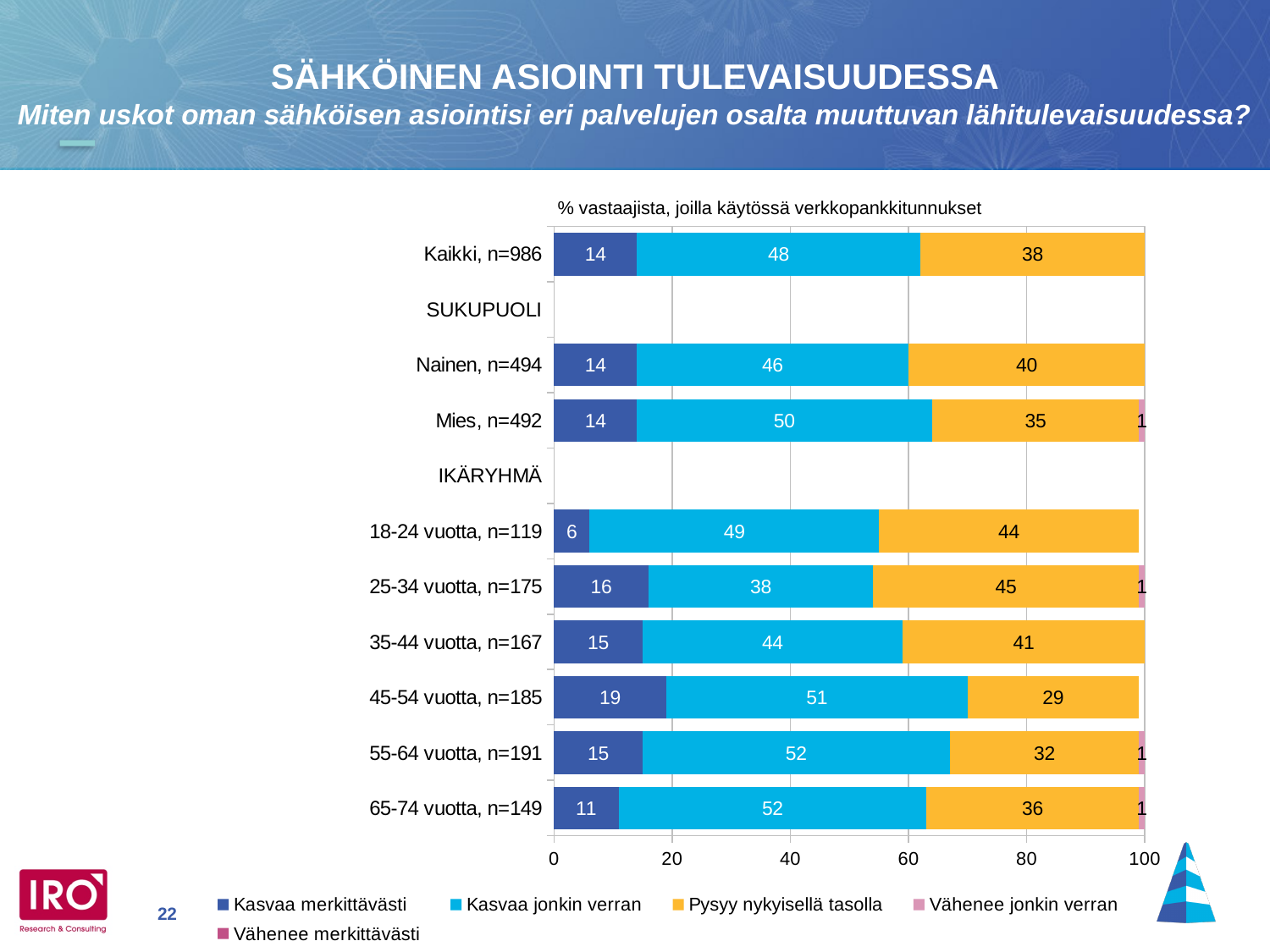
Which age group has the highest value for 'Kasvaa merkittävästi'? 45-54 vuotta, n=185 What percentage of all respondents (Kaikki, n=986) answered 'Kasvaa jonkin verran'? 48 What kind of chart is shown on the slide? Stacked bar chart What is the title shown above the chart? % vastaajista, joilla käytössä verkkopankkitunnukset What is the value of 'Kasvaa merkittävästi' for the 65-74 vuotta, n=149 group? 11 Which has a larger 'Kasvaa jonkin verran' value, Nainen, n=494 or Mies, n=492? Mies, n=492 Which age group has the lowest value for 'Kasvaa merkittävästi'? 18-24 vuotta, n=119 How many series does the legend list? 5 What is the value of 'Pysyy nykyisellä tasolla' for the 18-24 vuotta, n=119 group? 44 What is the total of the stacked bar for Kaikki, n=986? 100 What is the difference in 'Kasvaa jonkin verran' between the 45-54 vuotta group and the 25-34 vuotta group? 13 What is the difference in 'Pysyy nykyisellä tasolla' between Nainen, n=494 and Mies, n=492? 5